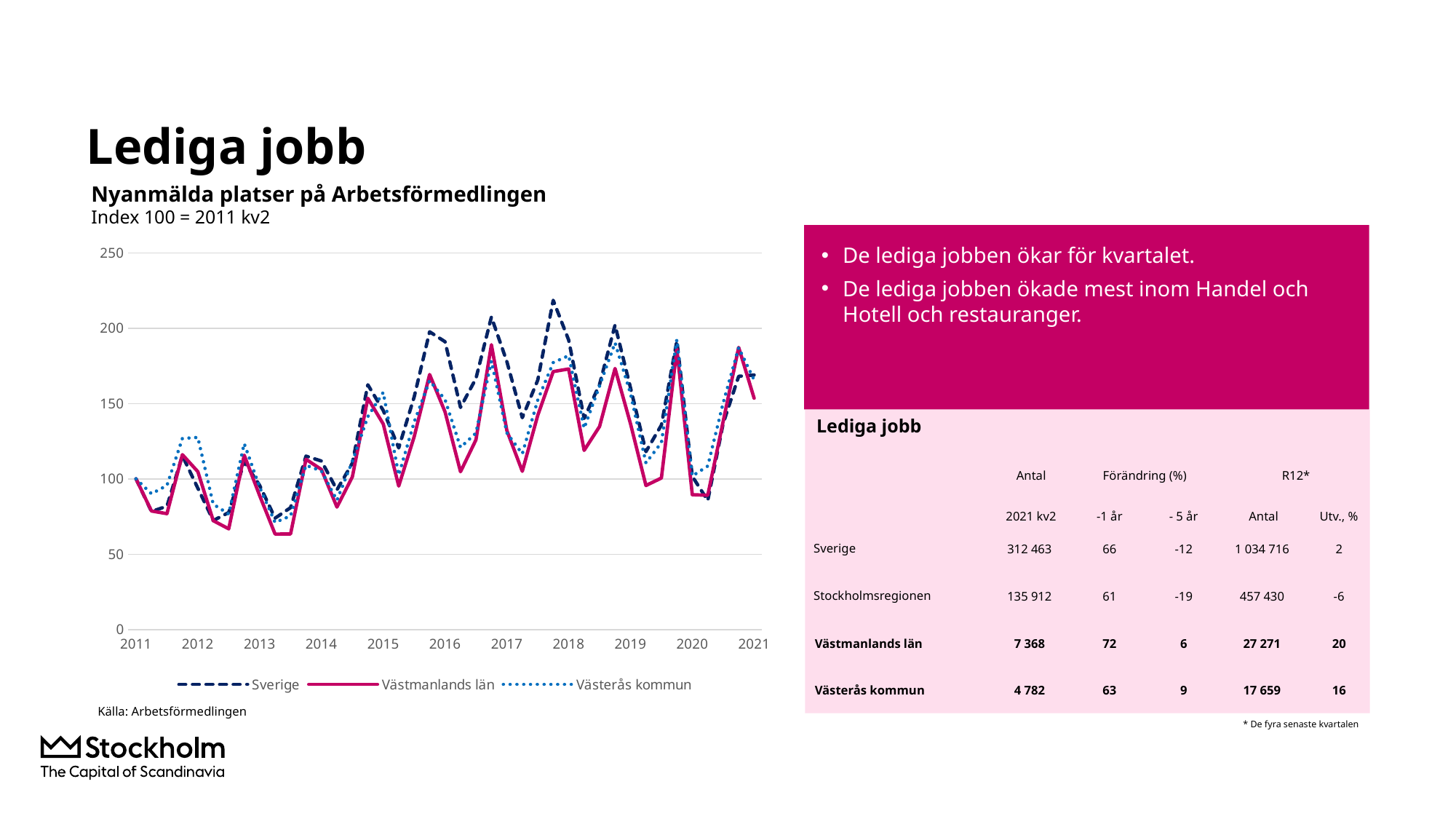
Does the Västmanlands län line end in 2021 higher or lower than its starting value in 2011? higher Which series reaches the highest index value on the chart? Sverige Which series are listed in the chart legend? Sverige, Västmanlands län, Västerås kommun What kind of chart is shown on the slide? line chart Is the peak value for Sverige in 2018 greater or less than 200? greater How many series does the chart legend list? 3 What is the subtitle of the chart above the plot area? Nyanmälda platser på Arbetsförmedlingen What is the index value for all three series at the start of the chart in 2011 kv2? 100 At the 2018 peak, which series is higher: Sverige or Västmanlands län? Sverige Is the lowest value for Västmanlands län around 2013 greater or less than 100? less How many year labels are shown on the x axis? 11 Is the peak value for Västmanlands län in 2018 greater or less than 200? less